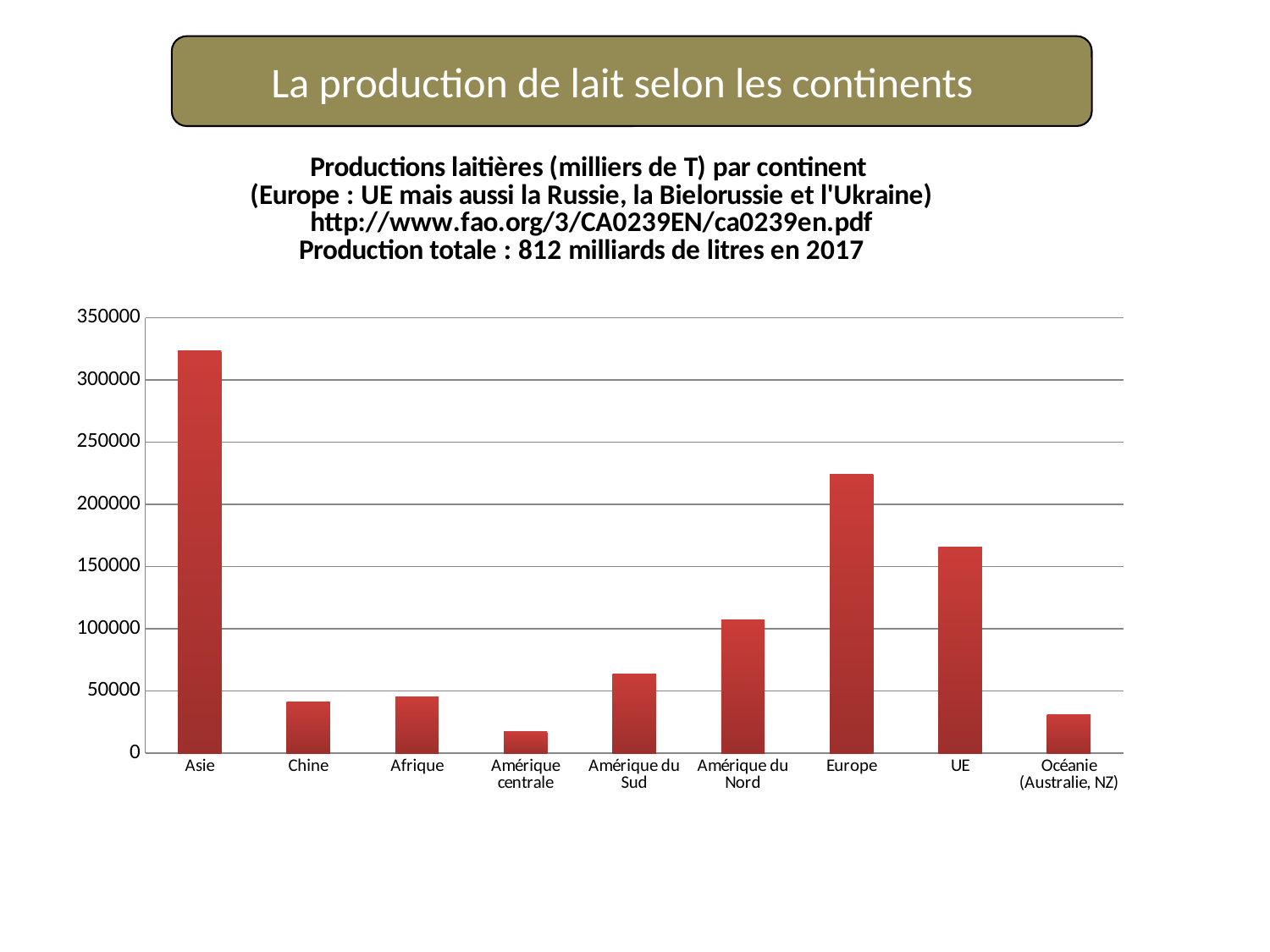
Is the value for Amérique du Sud greater or less than 100000? less How many categories are shown on the x axis of the chart? 9 What unit of measurement is given in the chart title for the milk production values? milliers de T What kind of chart is shown on the slide? Bar chart Is the value for Océanie (Australie, NZ) greater or less than 50000? less Which category has the lowest milk production in the chart? Amérique centrale Is the value for UE greater or less than 150000? greater Which category has the highest milk production in the chart? Asie Which has the larger value, Amérique du Nord or Amérique du Sud? Amérique du Nord Which has the larger value, Europe or UE? Europe